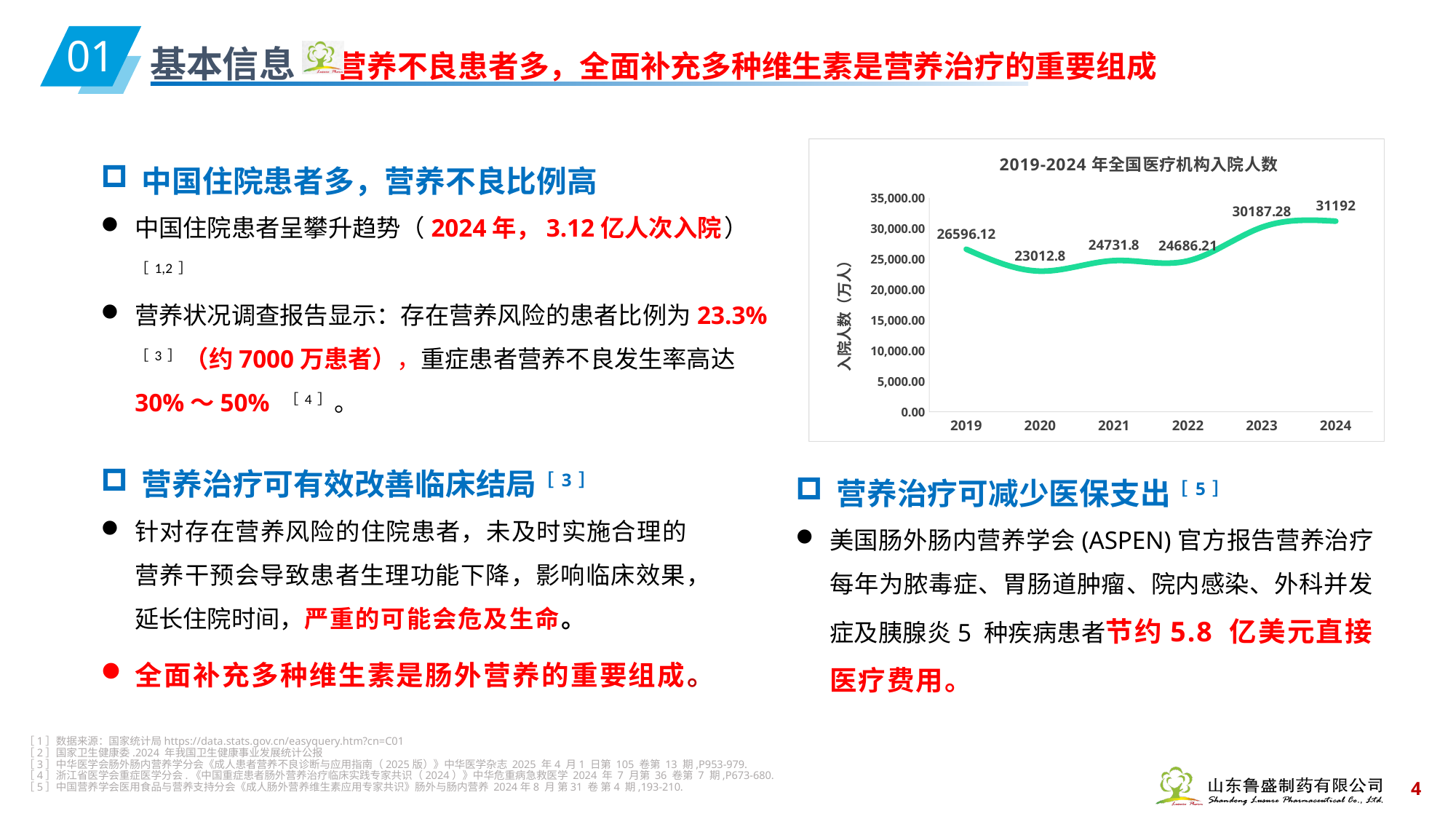
Which year has the highest value in the chart? 2024 What type of chart is shown on the slide? line chart What is the value for 2022 in the chart? 24686.21 What is the difference between the values for 2019 and 2020? 3583.32 What is the value for 2019 in the chart? 26596.12 How many data points are plotted in the chart? 6 What is the label of the y axis in the chart? 入院人数（万人） What is the title of the chart? 2019-2024 年全国医疗机构入院人数 Which is larger, the value for 2023 or the value for 2020? 2023 What is the difference between the values for 2024 and 2023? 1004.72 What is the value for 2024 in the chart? 31192 Which year has the lowest value in the chart? 2020